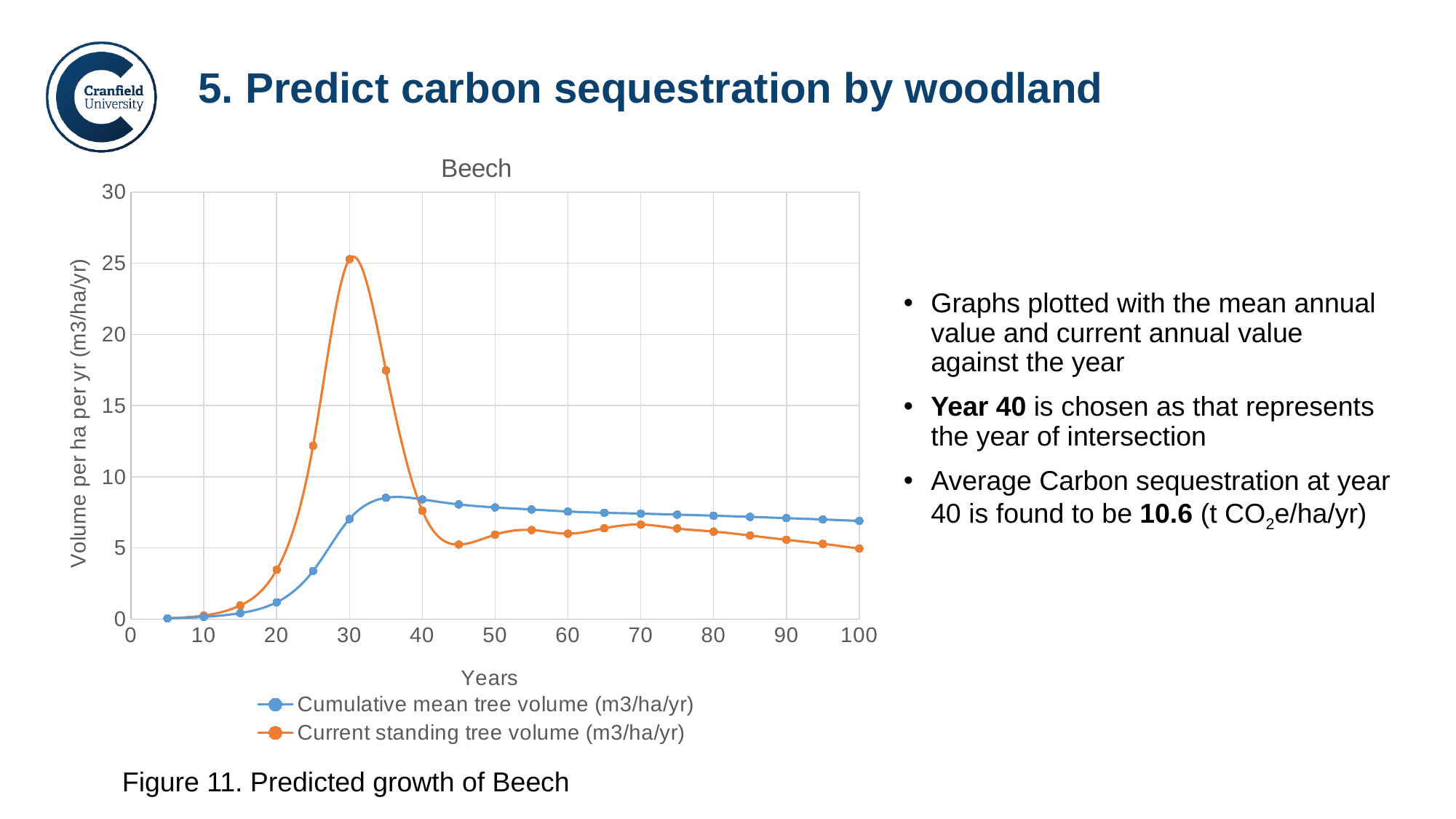
Is the value for Current standing tree volume at year 30 greater or less than 20? greater What is the label of the x axis? Years Is the value for Current standing tree volume at year 25 greater or less than 10? greater At year 100, which series has the larger value? Cumulative mean tree volume (m3/ha/yr) Is the value for Cumulative mean tree volume at year 35 greater or less than 10? less At year 30, which series has the larger value? Current standing tree volume (m3/ha/yr) At which year does the Current standing tree volume series reach its highest value? 30 What is the title of the chart? Beech What kind of chart is shown on the slide? Line chart Does the Cumulative mean tree volume series rise or fall between year 40 and year 100? fall How many series does the legend list? 2 Which series reaches the higher peak value, Cumulative mean tree volume or Current standing tree volume? Current standing tree volume (m3/ha/yr)